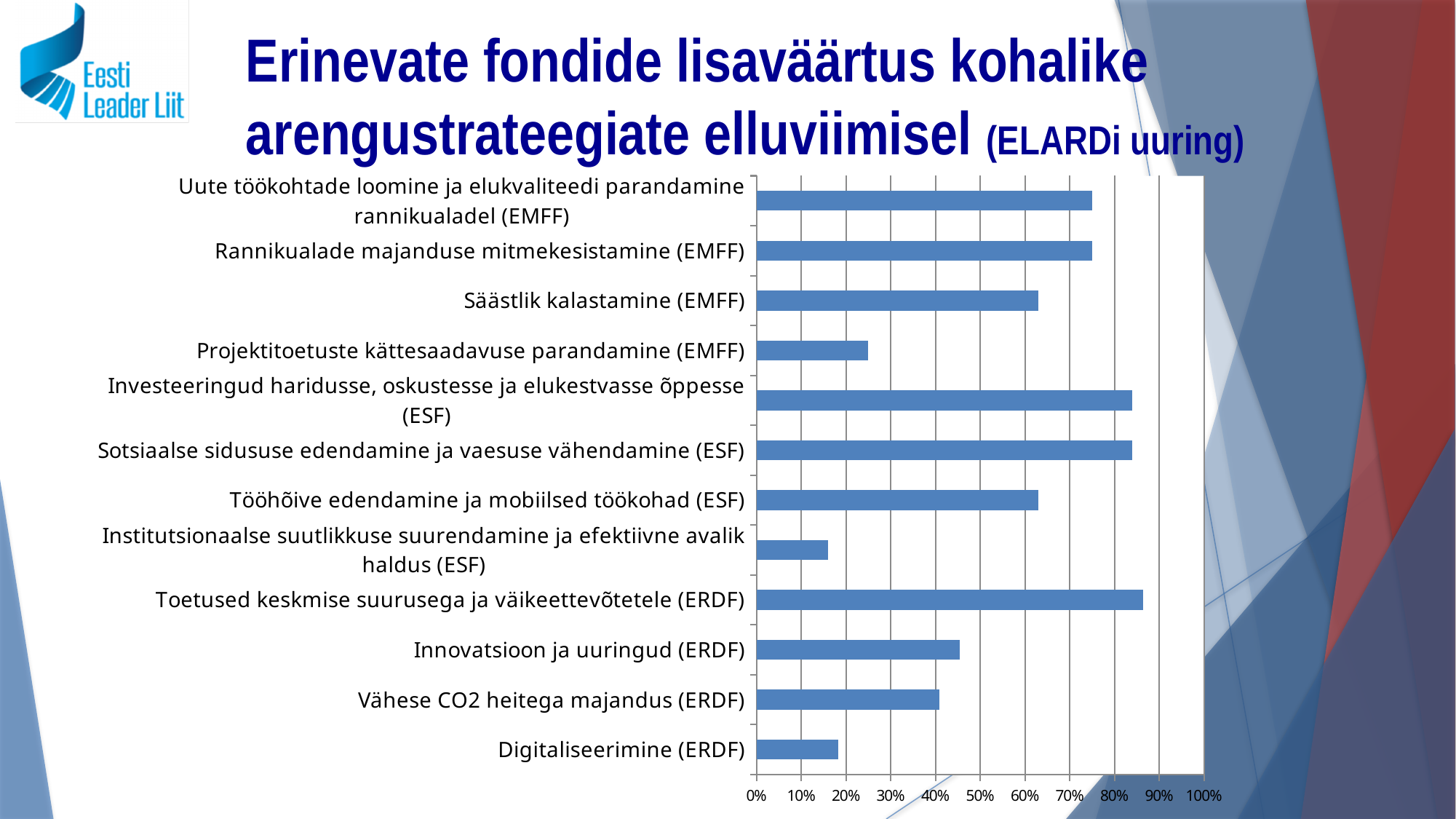
Is the value for Toetused keskmise suurusega ja väikeettevõtetele (ERDF) greater or less than 80%? greater Is the value for Säästlik kalastamine (EMFF) greater or less than 60%? greater Which is larger: the value for Vähese CO2 heitega majandus (ERDF) or the value for Sotsiaalse sidususe edendamine ja vaesuse vähendamine (ESF)? Sotsiaalse sidususe edendamine ja vaesuse vähendamine (ESF) Is the value for Digitaliseerimine (ERDF) greater or less than 20%? less Which is larger: the value for Institutsionaalse suutlikkuse suurendamine ja efektiivne avalik haldus (ESF) or the value for Tööhõive edendamine ja mobiilsed töökohad (ESF)? Tööhõive edendamine ja mobiilsed töökohad (ESF) What is the highest value shown on the horizontal axis of the chart? 100% Which is larger: the value for Säästlik kalastamine (EMFF) or the value for Projektitoetuste kättesaadavuse parandamine (EMFF)? Säästlik kalastamine (EMFF) How many categories are plotted in the chart? 12 What kind of chart is shown on the slide? bar chart